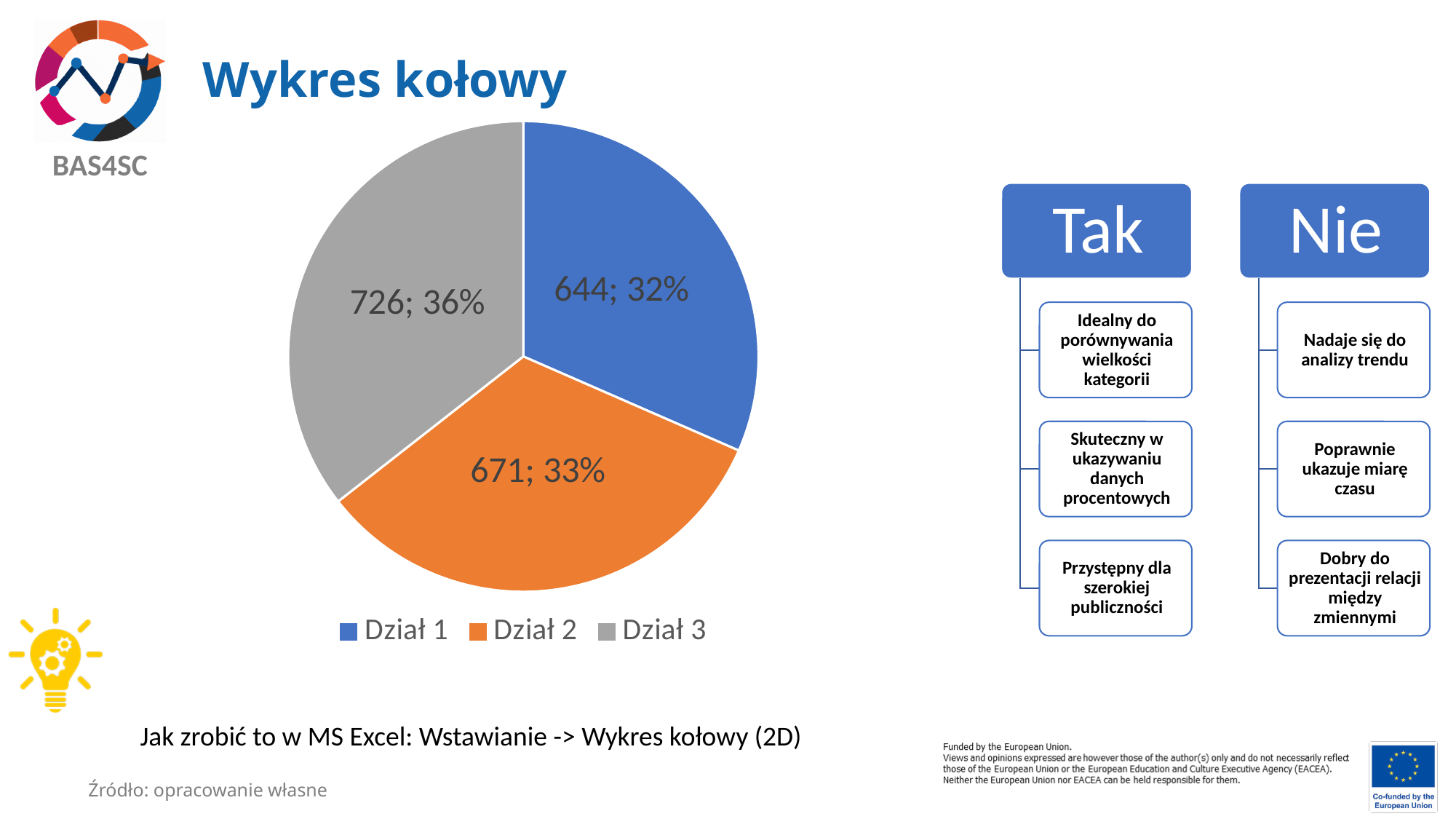
What share of the pie does Dział 3 represent? 36% Which category has the smallest slice? Dział 1 What share of the pie does Dział 1 represent? 32% What is the value for Dział 1? 644 How many categories does the pie chart have? 3 What is the value for Dział 2? 671 What kind of chart is shown on the slide? pie chart What is the total of all three slices? 2041 Which category has the largest slice? Dział 3 What is the difference between the values for Dział 3 and Dział 1? 82 What colour is the slice for Dział 2? orange What is the value for Dział 3? 726